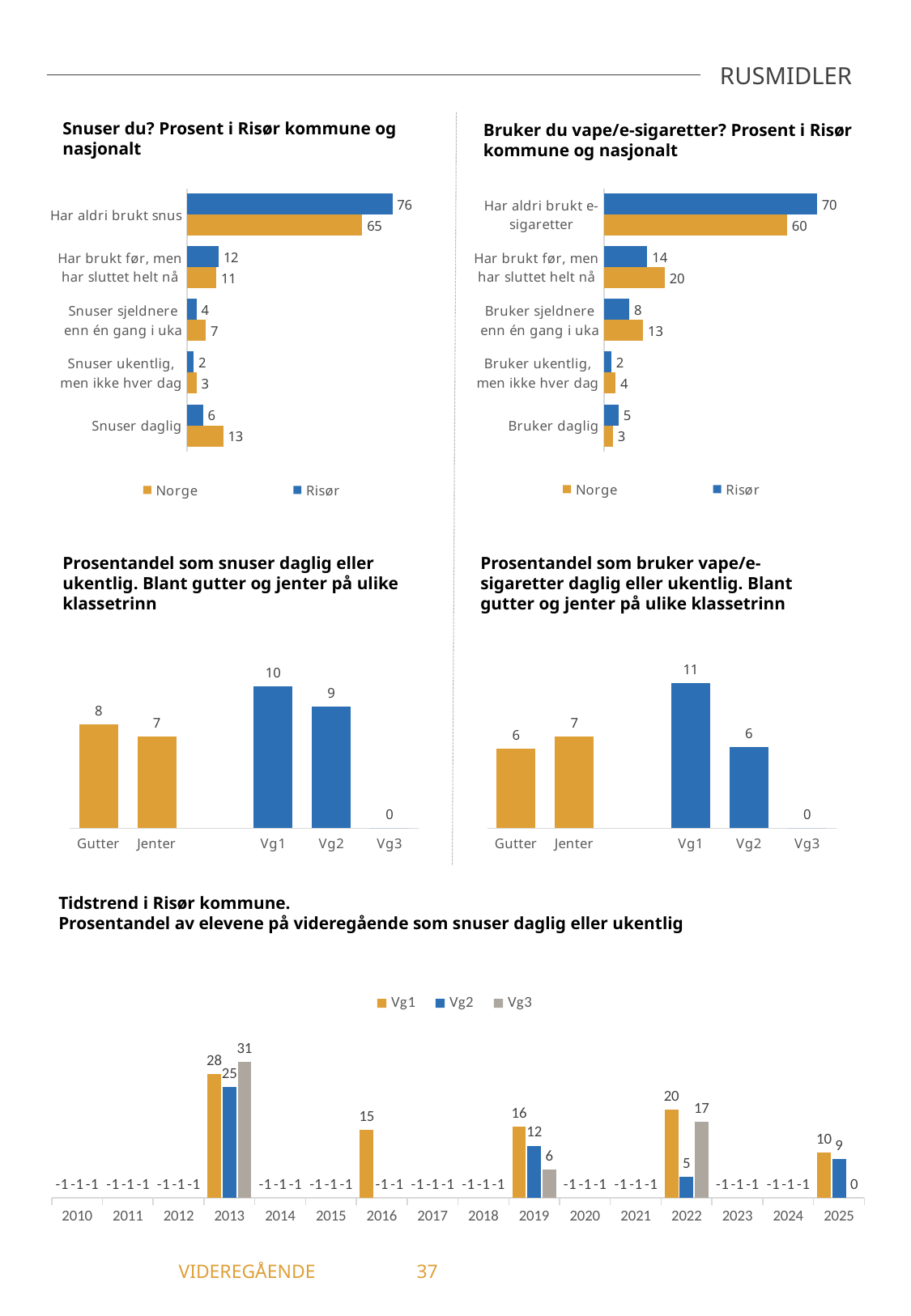
In the chart 'Tidstrend i Risør kommune', what is the value for Vg3 in 2013? 31 In the chart 'Snuser du? Prosent i Risør kommune og nasjonalt', how many series does the legend list? 2 In the chart 'Bruker du vape/e-sigaretter? Prosent i Risør kommune og nasjonalt', which is larger for 'Bruker daglig', Norge or Risør? Risør In the chart 'Bruker du vape/e-sigaretter? Prosent i Risør kommune og nasjonalt', how many categories are shown? 5 In the chart 'Tidstrend i Risør kommune', what is the difference between the Vg1 values for 2022 and 2025? 10 In the chart 'Prosentandel som bruker vape/e-sigaretter daglig eller ukentlig. Blant gutter og jenter på ulike klassetrinn', what kind of chart is it? Bar chart In the chart 'Bruker du vape/e-sigaretter? Prosent i Risør kommune og nasjonalt', what is the value for Norge in the category 'Har brukt før, men har sluttet helt nå'? 20 In the chart 'Snuser du? Prosent i Risør kommune og nasjonalt', what is the value for Risør in the category 'Har aldri brukt snus'? 76 In the chart 'Prosentandel som snuser daglig eller ukentlig. Blant gutter og jenter på ulike klassetrinn', what is the value for Gutter? 8 In the chart 'Snuser du? Prosent i Risør kommune og nasjonalt', what is the difference between the Norge and Risør values for 'Snuser daglig'? 7 In the chart 'Prosentandel som bruker vape/e-sigaretter daglig eller ukentlig. Blant gutter og jenter på ulike klassetrinn', what is the value for Vg1? 11 In the chart 'Prosentandel som snuser daglig eller ukentlig. Blant gutter og jenter på ulike klassetrinn', which category has the highest value? Vg1